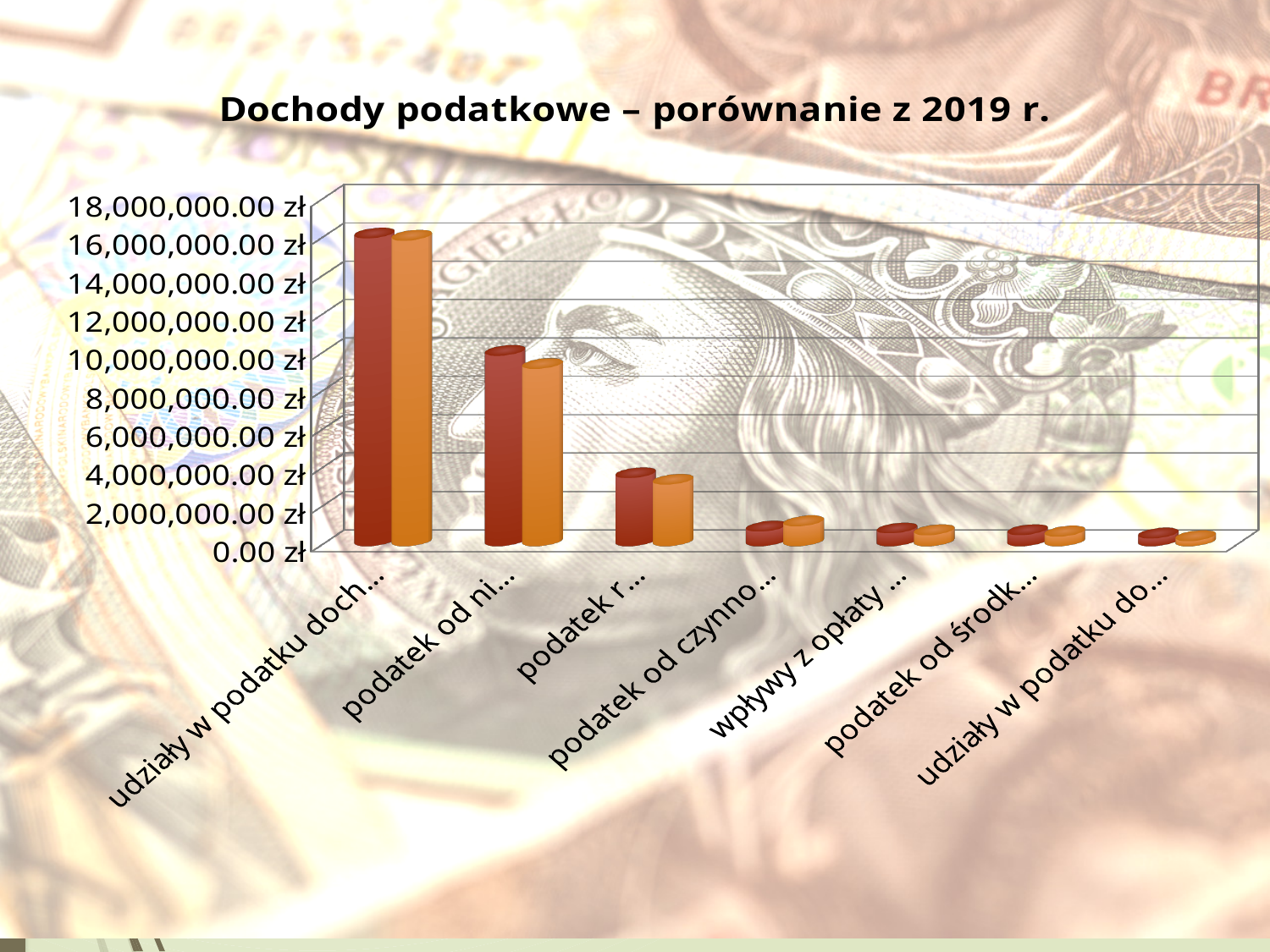
How many categories are shown on the x axis of the chart? 7 Which category has the highest values in the chart? udziały w podatku doch... Which category has larger values, 'udziały w podatku doch...' or 'podatek od ni...'? udziały w podatku doch... Do the values generally rise or fall moving from left to right along the x axis? fall Is the dark red bar for 'udziały w podatku doch...' greater or less than 14,000,000.00 zł? greater What kind of chart is shown on the slide? bar chart Is the dark red bar for 'podatek r...' greater or less than 4,000,000.00 zł? less For 'podatek od ni...', which bar is taller, the dark red one or the orange one? the dark red one Is the orange bar for 'podatek od czynno...' greater or less than 2,000,000.00 zł? less What is the title of the chart? Dochody podatkowe – porównanie z 2019 r. How many bars are plotted for each category? 2